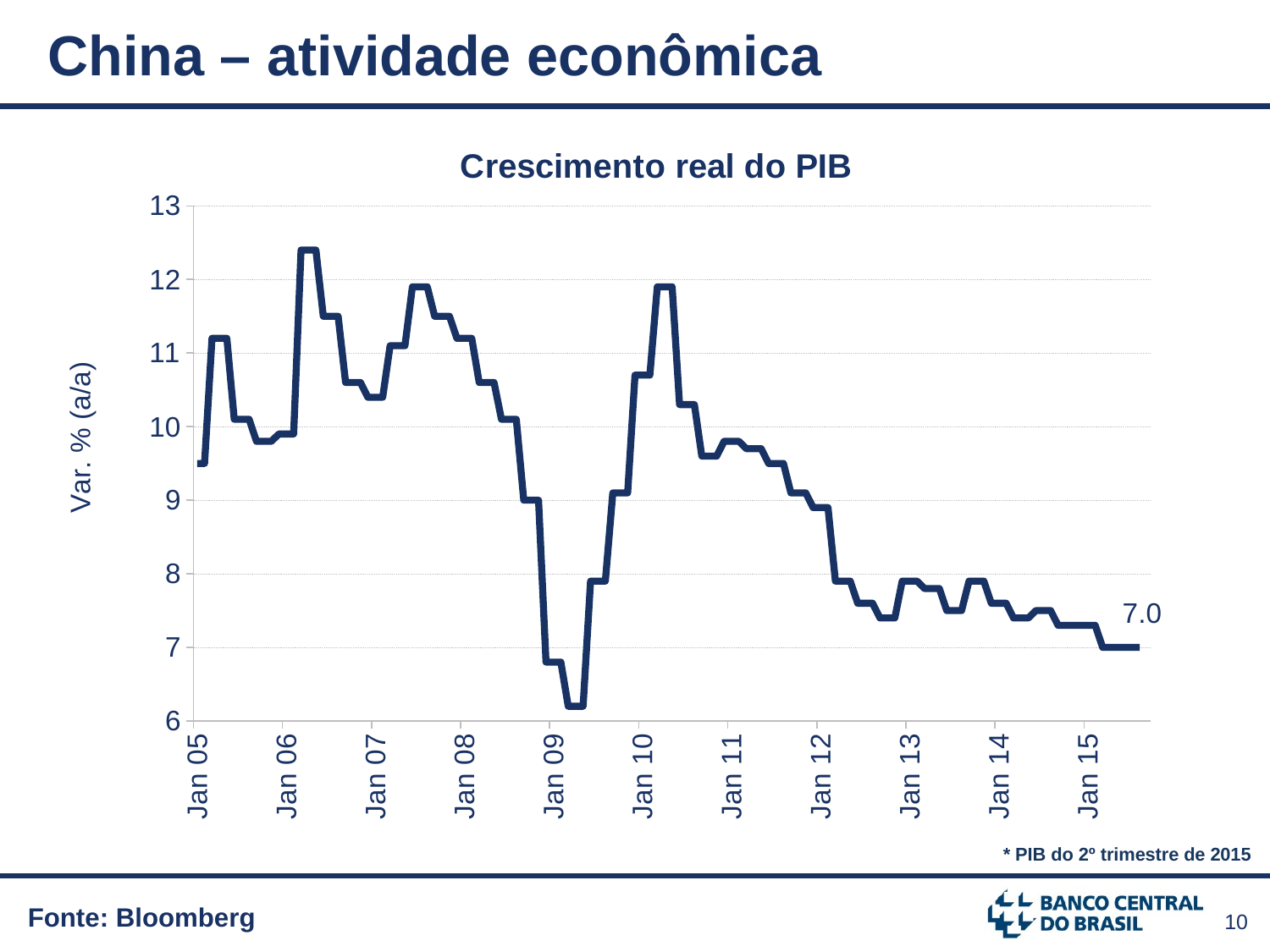
Is the value at Jan 13 greater or less than 9? less What is the label of the vertical axis? Var. % (a/a) Is the value at Jan 14 greater or less than 8? less In which year does the line reach its lowest point? 2009 What is the value of the last data point labelled on the chart? 7.0 Which is larger, the value at Jan 10 or the value at Jan 13? Jan 10 What is the title of the chart? Crescimento real do PIB What kind of chart is shown on the slide? line chart Is the value at Jan 10 greater or less than 10? greater Does the line generally rise or fall between Jan 12 and Jan 15? fall